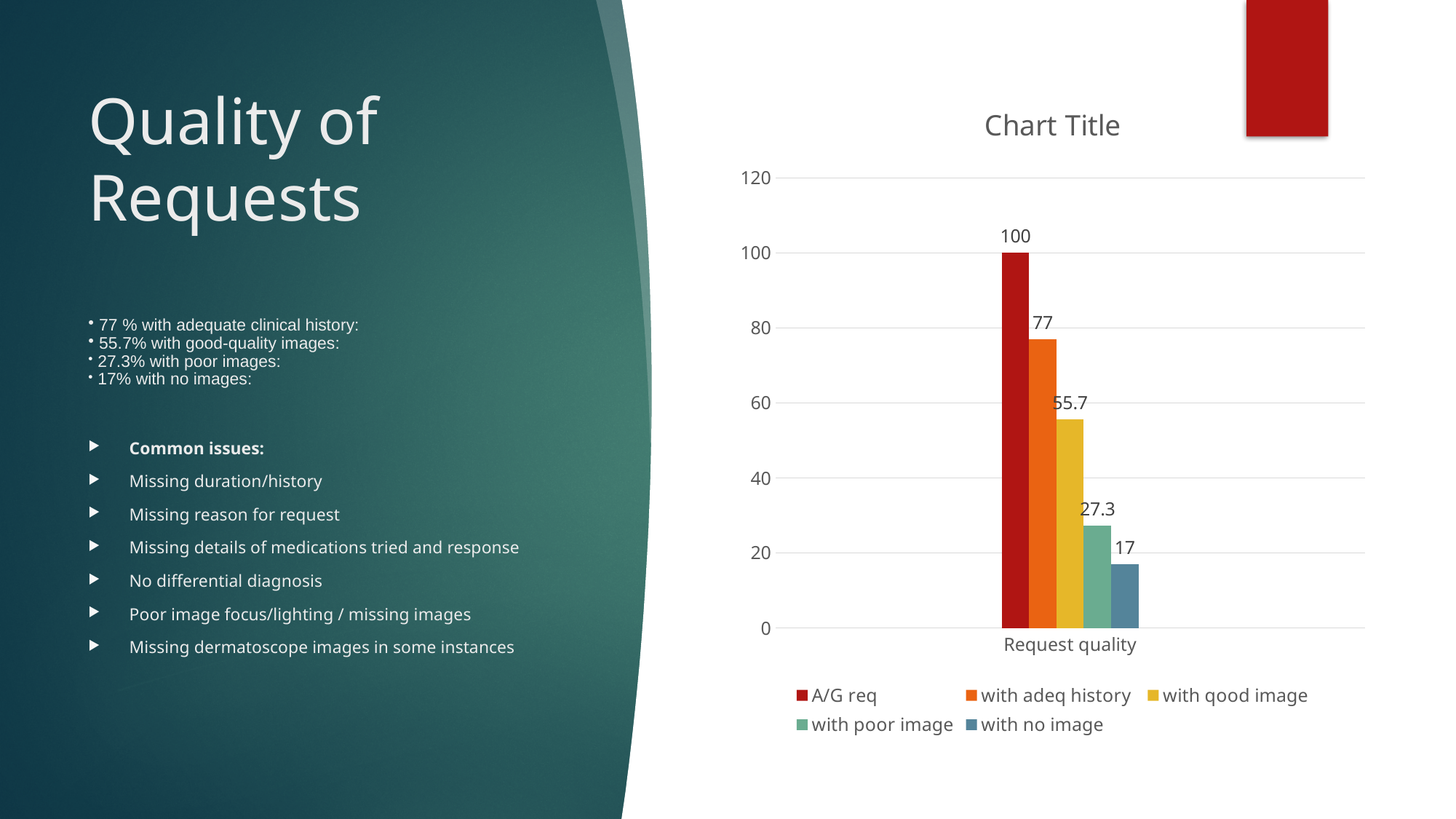
What is the value for the 'with poor image' series? 27.3 What is the value for the 'with qood image' series? 55.7 Which is larger, the value for 'with poor image' or the value for 'with no image'? with poor image What is the value for the 'with adeq history' series? 77 What is the title of the chart? Chart Title What is the value for the 'A/G req' series? 100 What kind of chart is shown on the slide? Bar chart How many series does the legend list? 5 Which series has the lowest value? with no image Which series has the highest value? A/G req What is the difference between the 'with adeq history' value and the 'with qood image' value? 21.3 What is the value for the 'with no image' series? 17